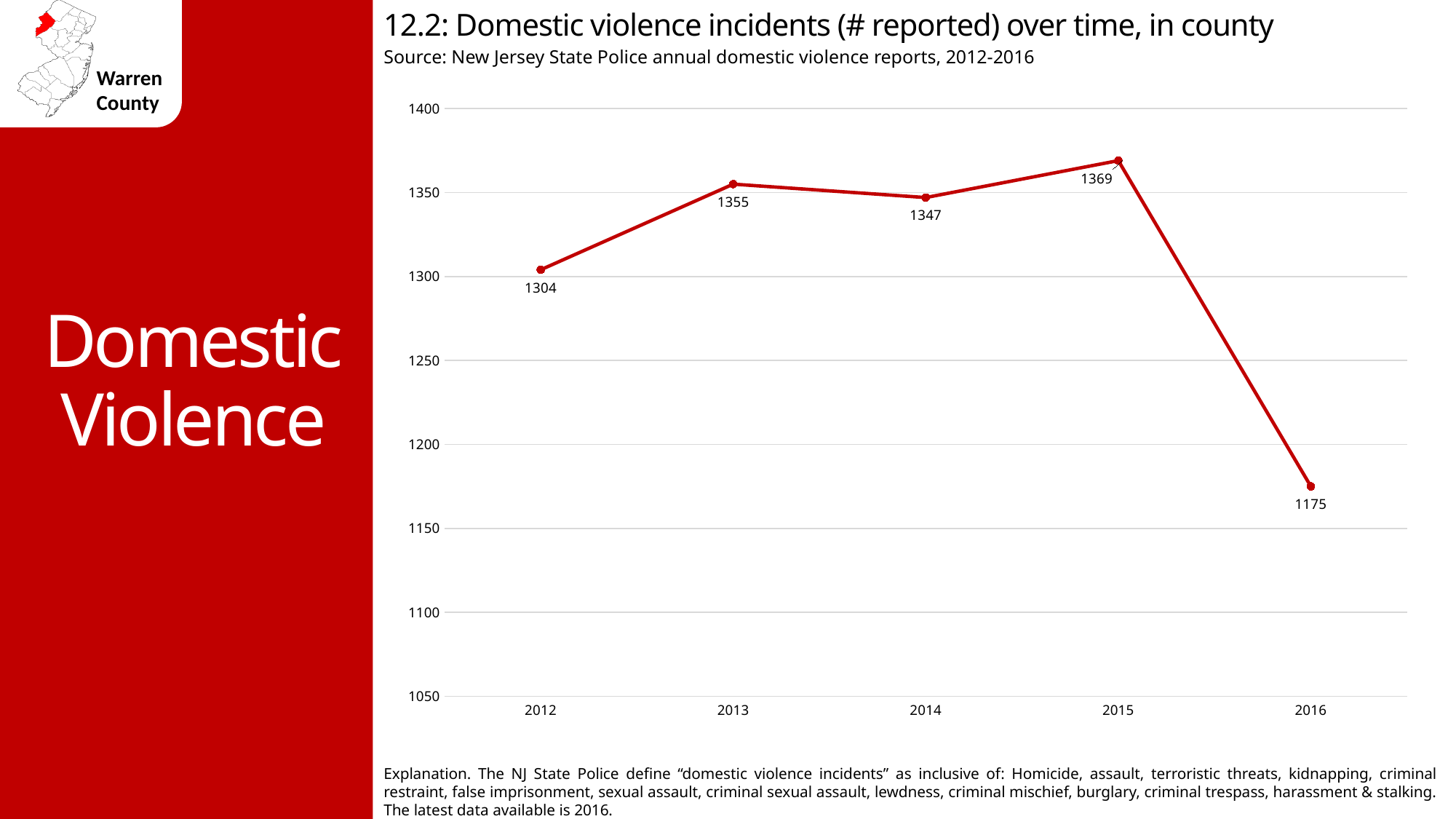
How many years are plotted on the chart? 5 Which year had more reported incidents, 2013 or 2014? 2013 How many incidents were reported in 2014? 1347 What kind of chart is shown on the slide? line chart Which year has the lowest number of reported domestic violence incidents? 2016 What is the value plotted for 2016? 1175 Is the value for 2016 greater or less than 1200? less What is the source of the data shown in the chart? New Jersey State Police annual domestic violence reports, 2012-2016 Which year has the highest number of reported domestic violence incidents? 2015 How many domestic violence incidents were reported in 2012? 1304 By how much did reported incidents increase from 2012 to 2013? 51 What is the difference between the 2015 value and the 2016 value? 194